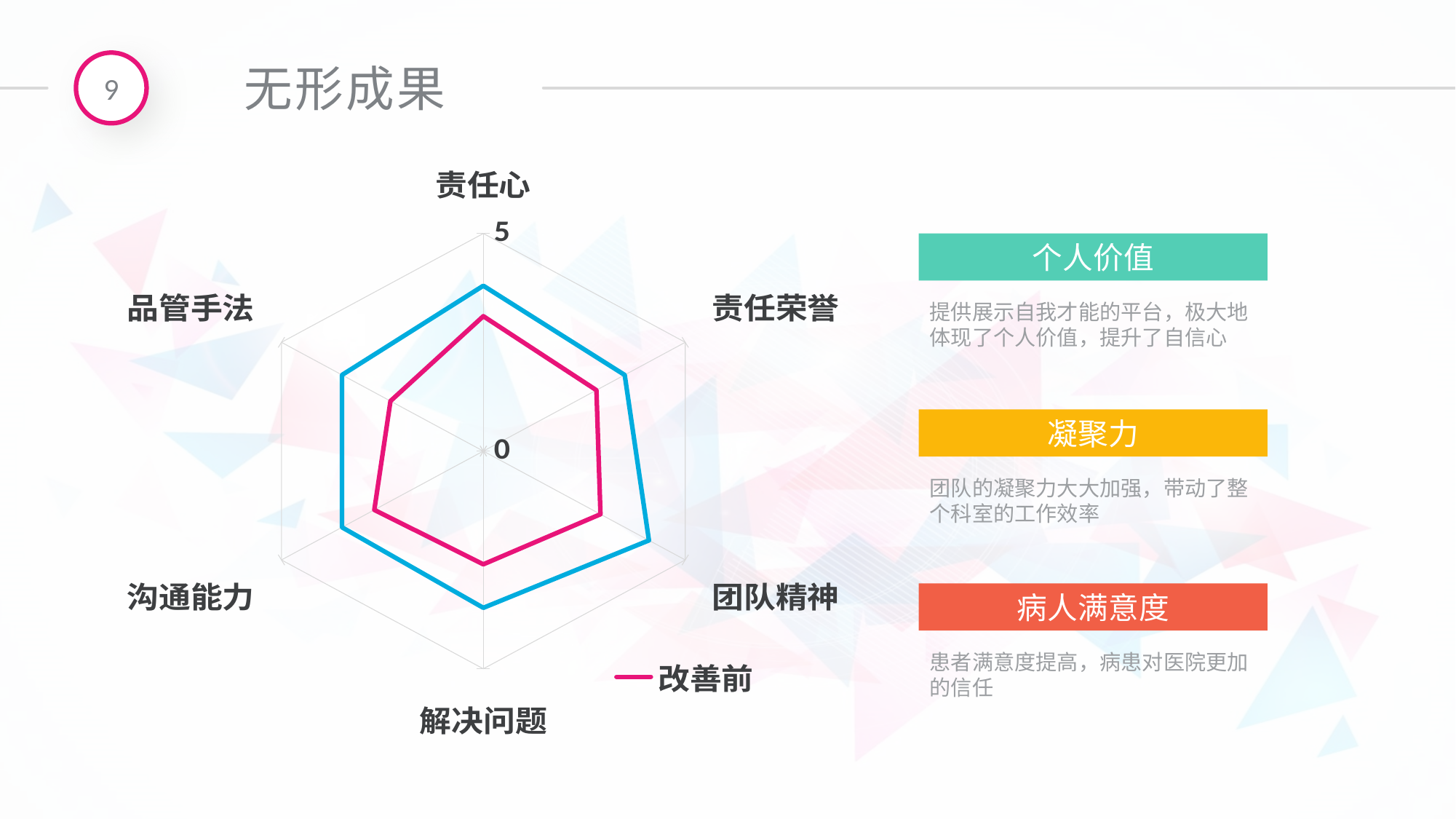
Which category is at the top of the radar chart? 责任心 What kind of chart is shown on the slide? Radar chart What is the name of the series shown in the chart legend? 改善前 What colour is the 改善前 line in the radar chart? Pink For 团队精神, which line has the larger value, the blue line or the pink 改善前 line? The blue line For 责任心, which line has the larger value, the blue line or the pink 改善前 line? The blue line What is the minimum value shown on the radar chart's axis? 0 On which category does the blue line reach its highest value? 团队精神 How many categories (axes) does the radar chart have? 6 How many series does the chart legend list? 1 What is the maximum value shown on the radar chart's axis? 5 Is the 改善前 value for 责任心 greater or less than 5? less